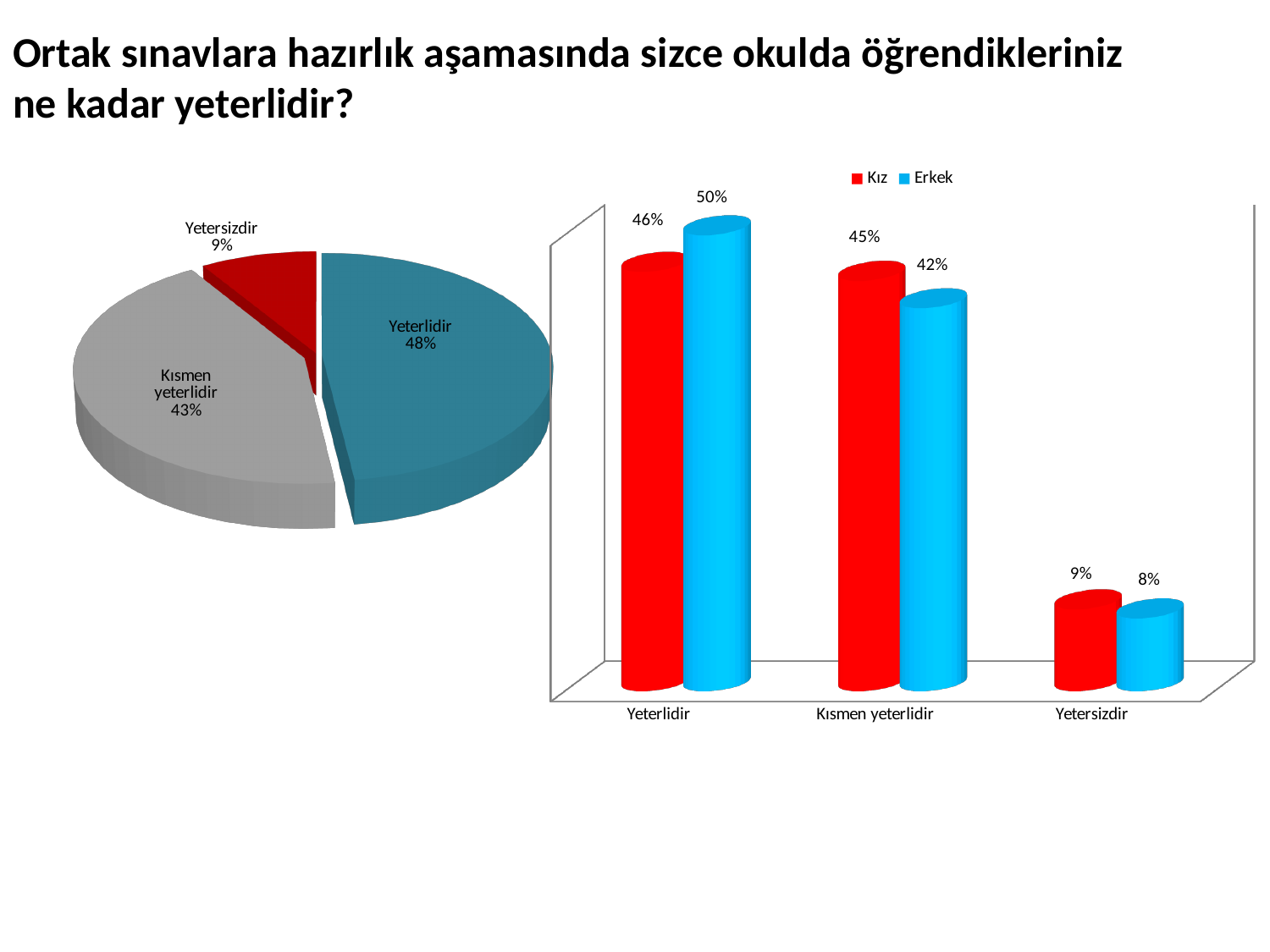
What kind of chart is on the right side of the slide? Bar chart In the bar chart on the right, what is the difference between Kız and Erkek in 'Yeterlidir'? 4% In the pie chart on the left, what share does 'Yeterlidir' have? 48% In the bar chart on the right, what is the value for Kız in 'Kısmen yeterlidir'? 45% In the pie chart on the left, how many slices are there? 3 In the bar chart on the right, which category has the lowest value for Kız? Yetersizdir In the bar chart on the right, which is larger in 'Kısmen yeterlidir', Kız or Erkek? Kız In the bar chart on the right, what is the value for Erkek in 'Yeterlidir'? 50% In the bar chart on the right, what is the value for Erkek in 'Yetersizdir'? 8% In the bar chart on the right, how many series does the legend list? 2 In the pie chart on the left, which category has the smallest slice? Yetersizdir In the pie chart on the left, what share does 'Kısmen yeterlidir' have? 43%